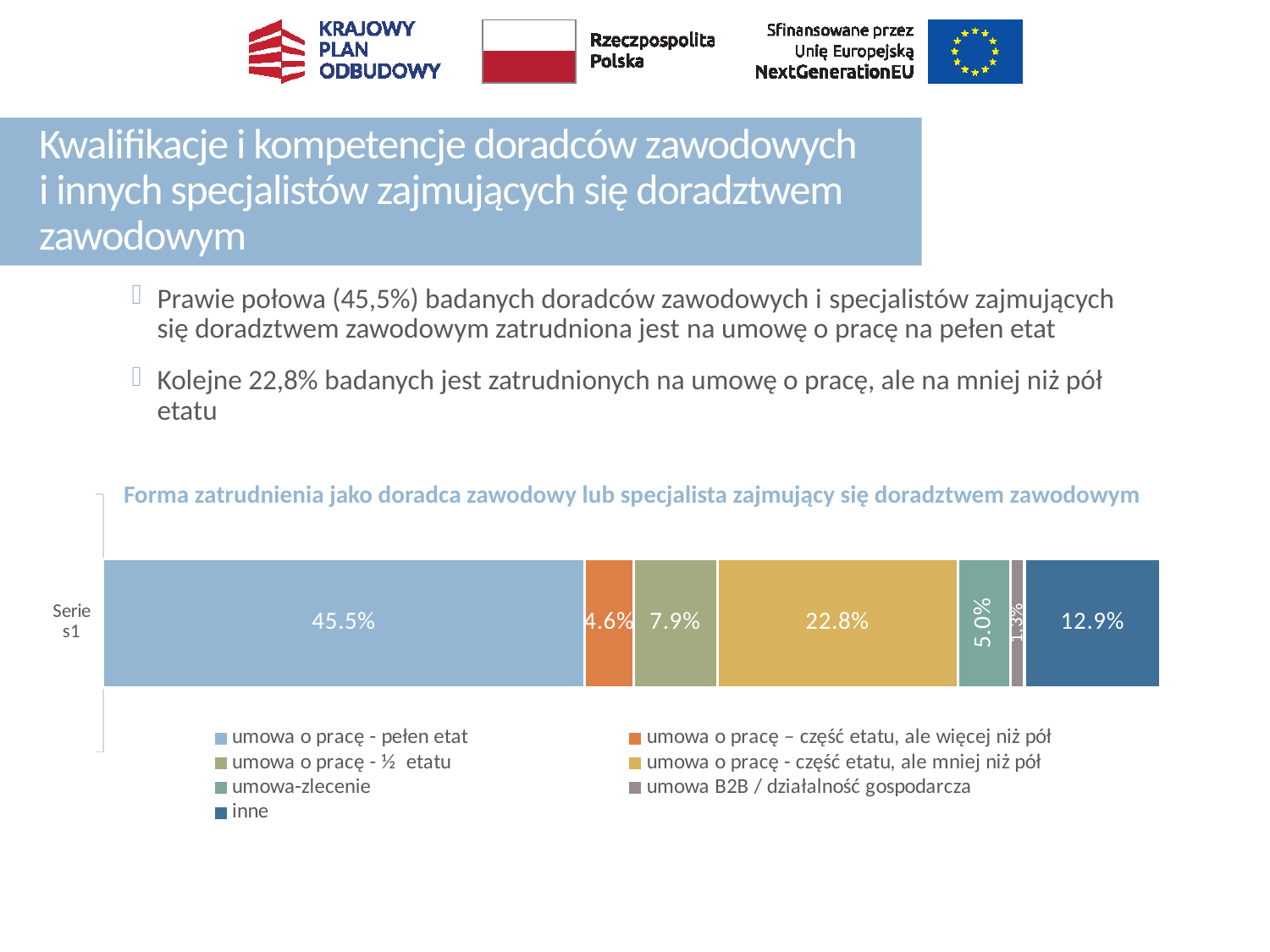
What is the value for 'umowa o pracę - część etatu, ale mniej niż pół'? 22.8% Which employment form has the highest share in the chart? umowa o pracę - pełen etat What is the value for 'umowa-zlecenie'? 5.0% What is the title of the chart? Forma zatrudnienia jako doradca zawodowy lub specjalista zajmujący się doradztwem zawodowym What is the total of all segments in the stacked bar? 100.0% How many series does the chart legend list? 7 Which employment form has the lowest share in the chart? umowa B2B / działalność gospodarcza Which is larger: the value for 'umowa o pracę - ½ etatu' or the value for 'umowa o pracę – część etatu, ale więcej niż pół'? umowa o pracę - ½ etatu What is the difference between the values for 'umowa o pracę - pełen etat' and 'umowa o pracę - część etatu, ale mniej niż pół'? 22.7% What is the value for 'inne'? 12.9% What is the value for 'umowa o pracę - pełen etat'? 45.5% What type of chart is shown on the slide? stacked bar chart